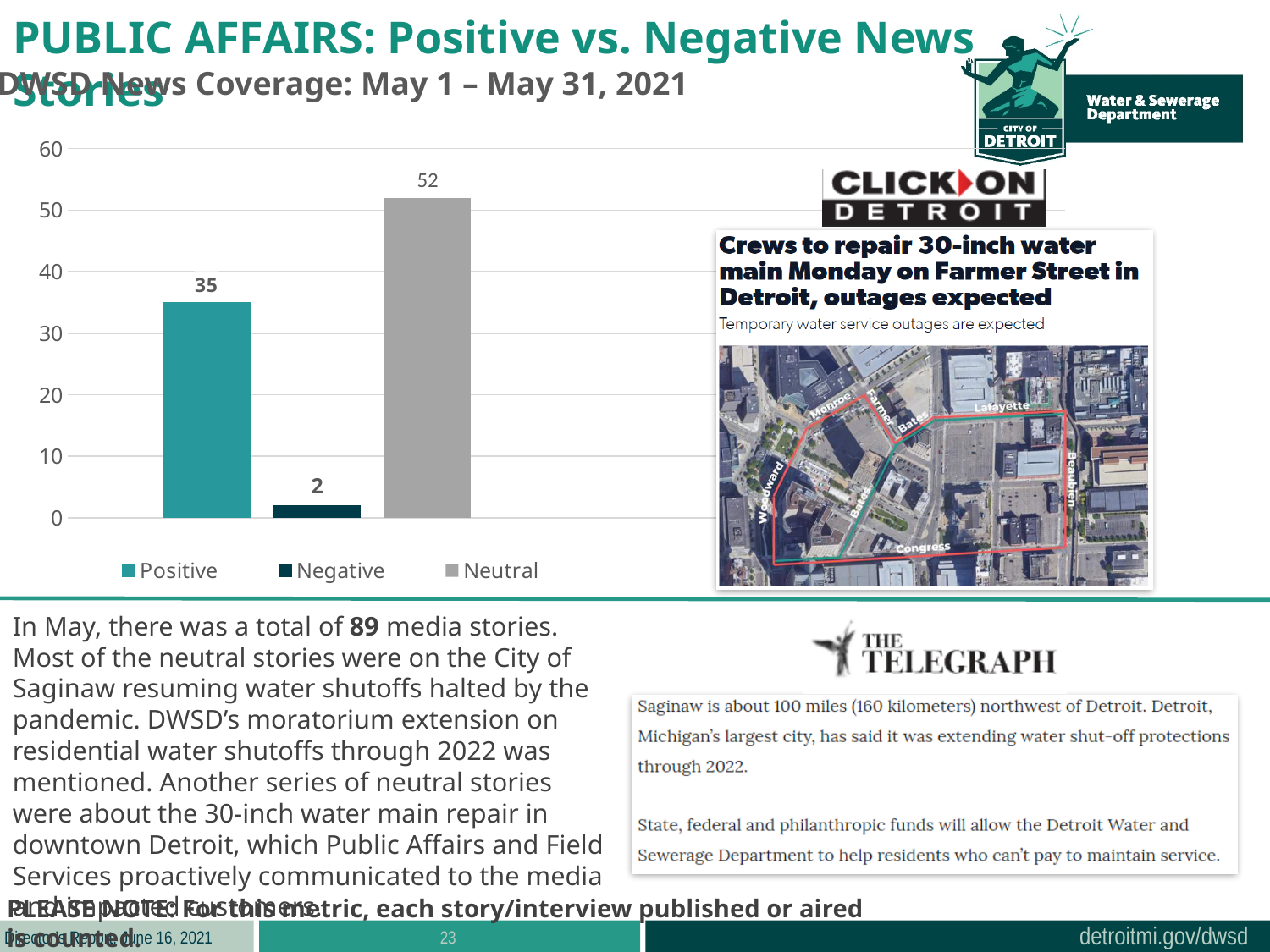
How many categories are shown in the chart? 3 How many entries does the chart legend list? 3 Which category has the lowest value in the chart? Negative What kind of chart is shown on the slide? Bar chart What is the difference between the Neutral and Positive values? 17 What is the value for Positive news stories in the chart? 35 What is the value for Negative news stories in the chart? 2 Which category has the highest value in the chart? Neutral What is the value for Neutral news stories in the chart? 52 What is the difference between the Positive and Negative values? 33 Which is larger, the Positive value or the Neutral value? Neutral What is the title of the chart? DWSD News Coverage: May 1 – May 31, 2021